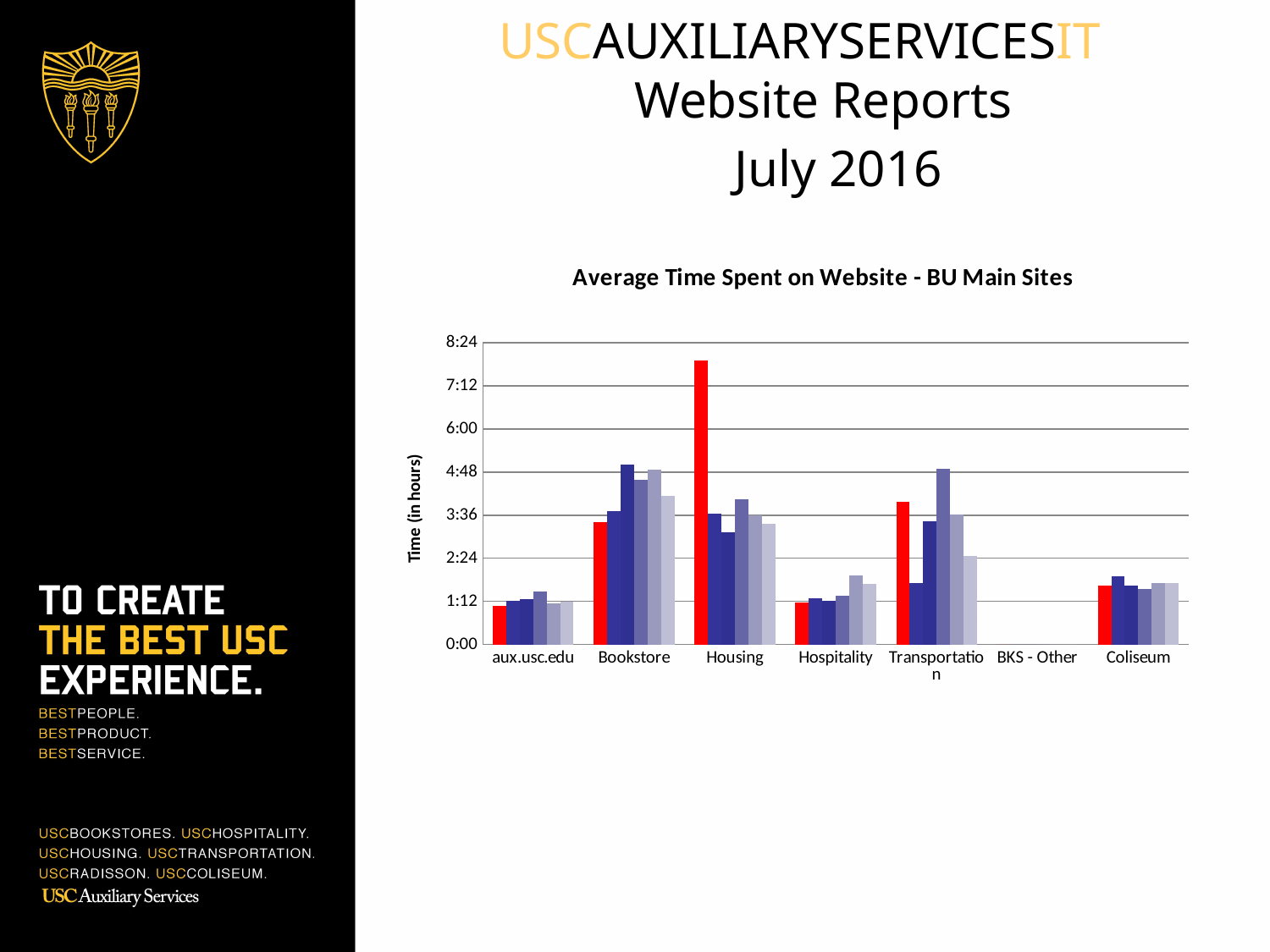
Which category on the x axis shows no visible bars? BKS - Other Is the red (first) bar for Transportation greater or less than 3:36? greater Which is larger, the red (first) bar for Transportation or the red (first) bar for Coliseum? Transportation Is the red (first) bar for Coliseum greater or less than 2:24? less What kind of chart is shown on the slide? bar chart Which is larger, the red (first) bar for Housing or the red (first) bar for Bookstore? Housing What is the label on the vertical axis of the chart? Time (in hours) Is the red (first) bar for Bookstore greater or less than 3:36? less What is the title of the chart? Average Time Spent on Website - BU Main Sites How many categories are listed along the x axis of the chart? 7 Which category contains the tallest bar in the chart? Housing